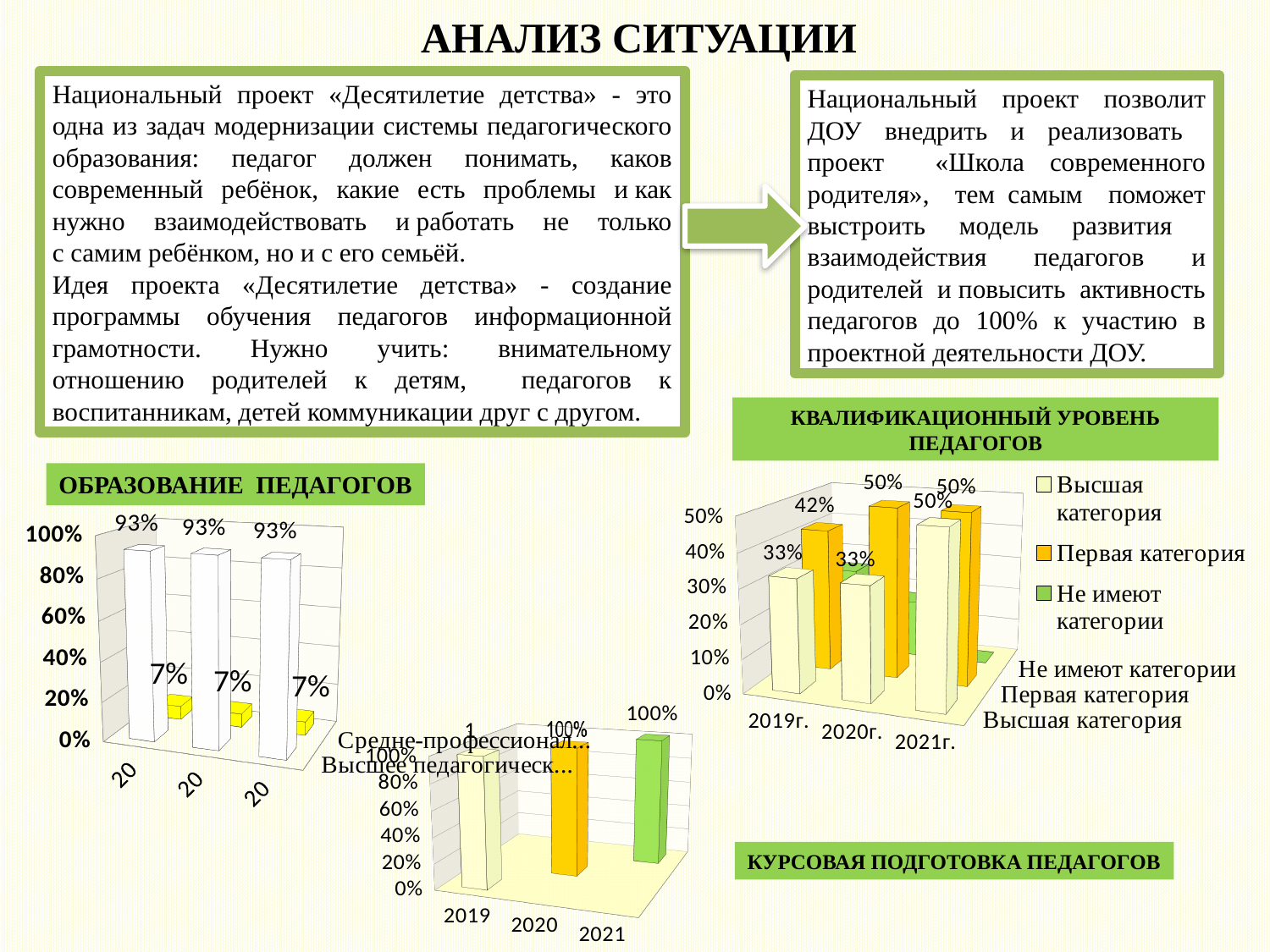
In the ОБРАЗОВАНИЕ ПЕДАГОГОВ chart, what value is labelled on each of the tall white bars? 93% In the КВАЛИФИКАЦИОННЫЙ УРОВЕНЬ ПЕДАГОГОВ chart, what is the value for Высшая категория in 2019г.? 33% In the КВАЛИФИКАЦИОННЫЙ УРОВЕНЬ ПЕДАГОГОВ chart, which is larger in 2019г.: Высшая категория or Первая категория? Первая категория What kind of chart is the КУРСОВАЯ ПОДГОТОВКА ПЕДАГОГОВ chart? bar chart In the КВАЛИФИКАЦИОННЫЙ УРОВЕНЬ ПЕДАГОГОВ chart, what is the value for Первая категория in 2019г.? 42% In the КУРСОВАЯ ПОДГОТОВКА ПЕДАГОГОВ chart, what is the value for 2021? 100% In the КВАЛИФИКАЦИОННЫЙ УРОВЕНЬ ПЕДАГОГОВ chart, does the value for Высшая категория rise or fall from 2019г. to 2021г.? rise In the КВАЛИФИКАЦИОННЫЙ УРОВЕНЬ ПЕДАГОГОВ chart, what is the difference between Первая категория and Высшая категория in 2019г.? 9 percentage points In the КВАЛИФИКАЦИОННЫЙ УРОВЕНЬ ПЕДАГОГОВ chart, what are the three legend entries? Высшая категория, Первая категория, Не имеют категории In the ОБРАЗОВАНИЕ ПЕДАГОГОВ chart, what value is labelled on each of the short yellow bars? 7% In the КВАЛИФИКАЦИОННЫЙ УРОВЕНЬ ПЕДАГОГОВ chart, how many series does the legend list? 3 In the КВАЛИФИКАЦИОННЫЙ УРОВЕНЬ ПЕДАГОГОВ chart, what is the value for Высшая категория in 2021г.? 50%